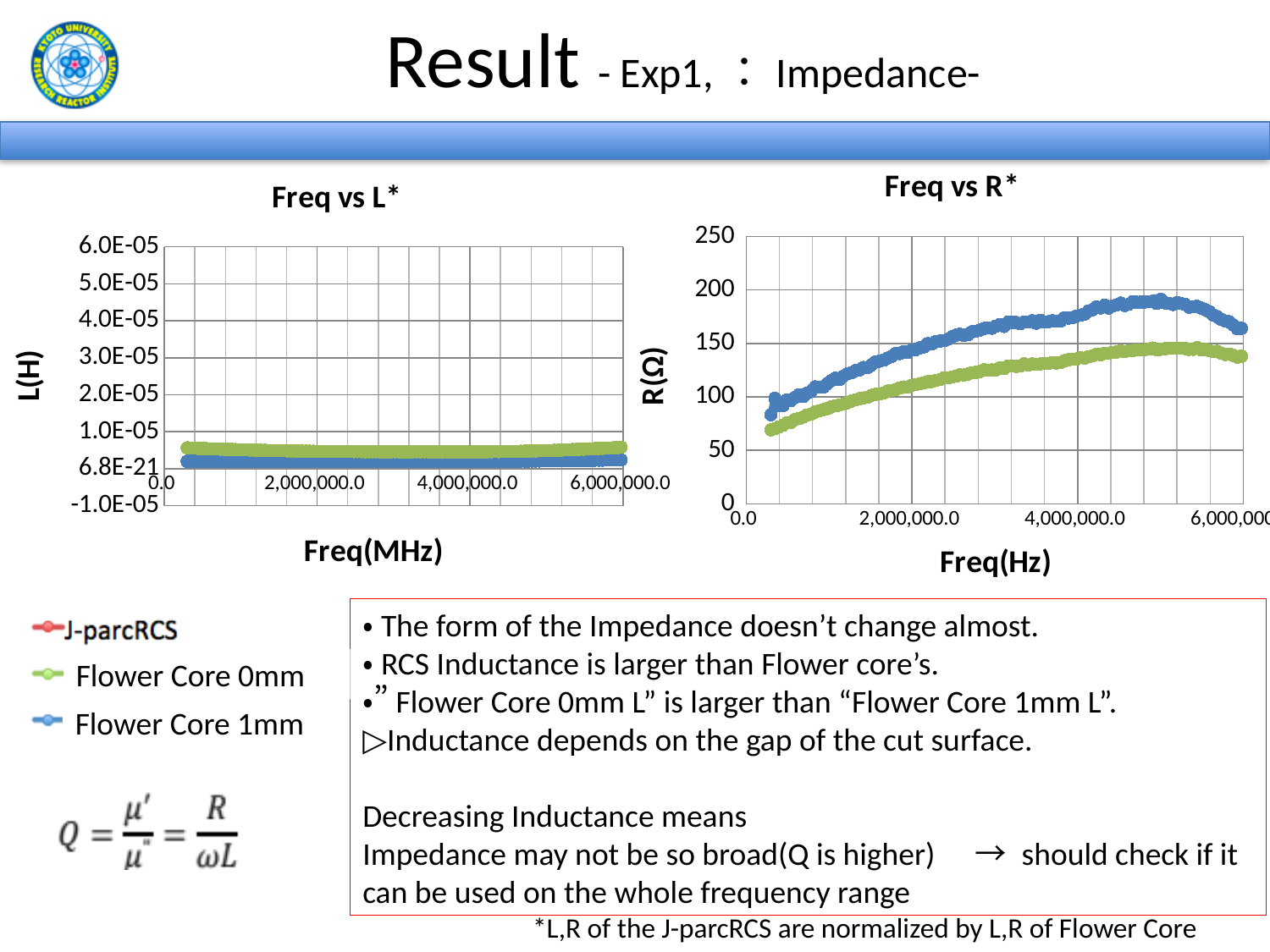
In the "Freq vs R*" chart, is the peak value of the Flower Core 0mm series greater or less than 100? greater What kind of chart is the "Freq vs R*" chart? scatter chart What is the x-axis label of the "Freq vs L*" chart? Freq(MHz) In the "Freq vs R*" chart, is the peak value of the Flower Core 1mm series greater or less than 150? greater In the "Freq vs R*" chart, do the values of the Flower Core 0mm series generally rise or fall as frequency increases from 0 to 4,000,000? rise How many series does the legend list? 3 In the "Freq vs L*" chart, are the values of the Flower Core 1mm series greater or less than 1.0E-05? less What is the y-axis label of the "Freq vs R*" chart? R(Ω) In the "Freq vs L*" chart, which series has the higher values, Flower Core 0mm or Flower Core 1mm? Flower Core 0mm In the "Freq vs R*" chart, which series has the higher values, Flower Core 0mm or Flower Core 1mm? Flower Core 1mm What is the maximum value shown on the y-axis of the "Freq vs R*" chart? 250